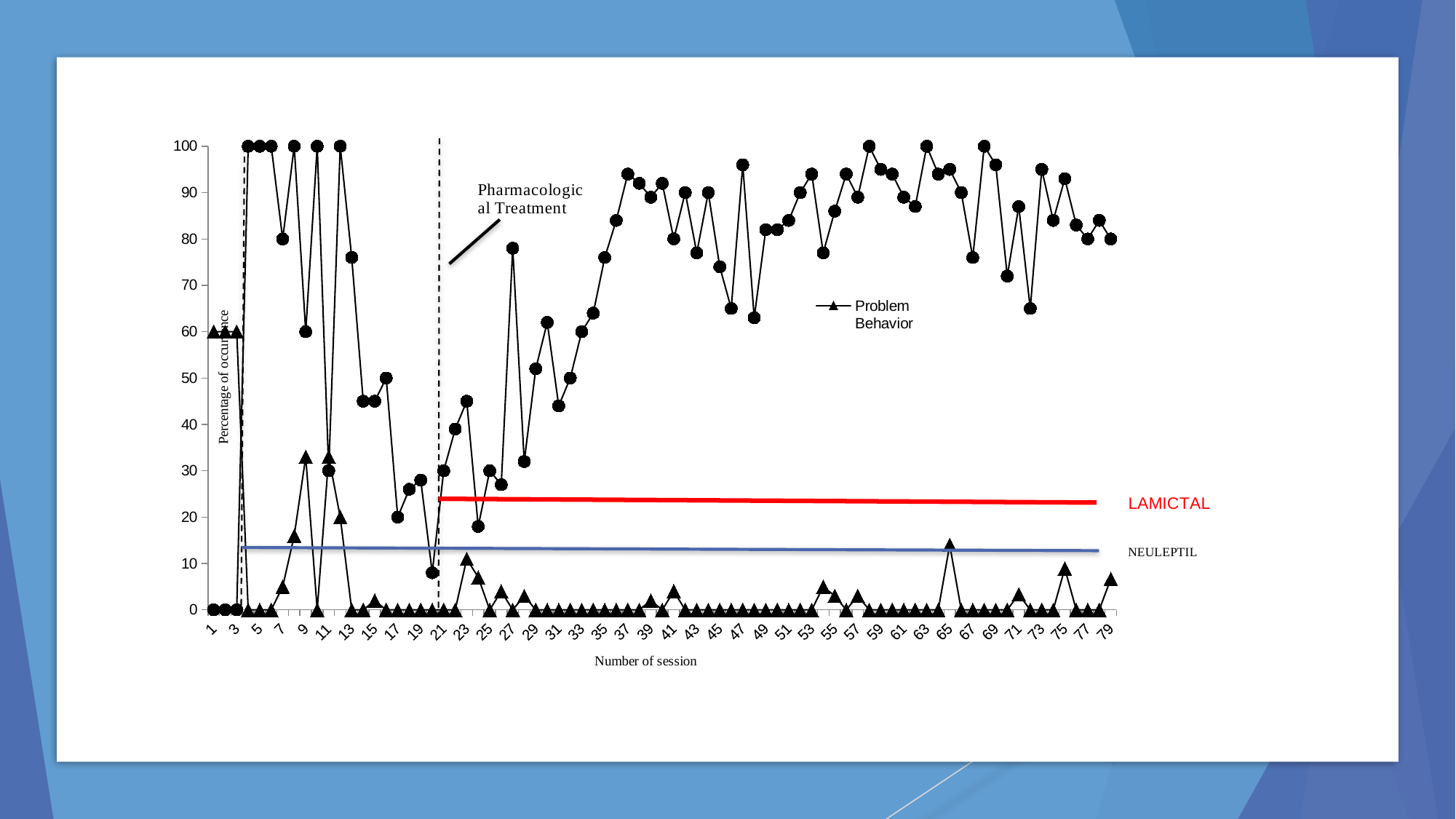
Which has the larger circle-marker value, session 27 or session 28? session 27 What kind of chart is shown on the slide? line chart What is the value of the circle-marker series at session 7? 80 What is the last session number shown on the x axis? 79 Does the circle-marker series generally rise or fall between session 21 and session 37? rise What series name does the legend list? Problem Behavior Is the value of the circle-marker series at session 27 greater or less than 70? greater What is the title of the x axis? Number of session What is the value of the Problem Behavior (triangle) series at session 1? 60 What is the highest value reached by the circle-marker series? 100 What is the value of the circle-marker series at session 9? 60 What is the value of the circle-marker series at session 17? 20